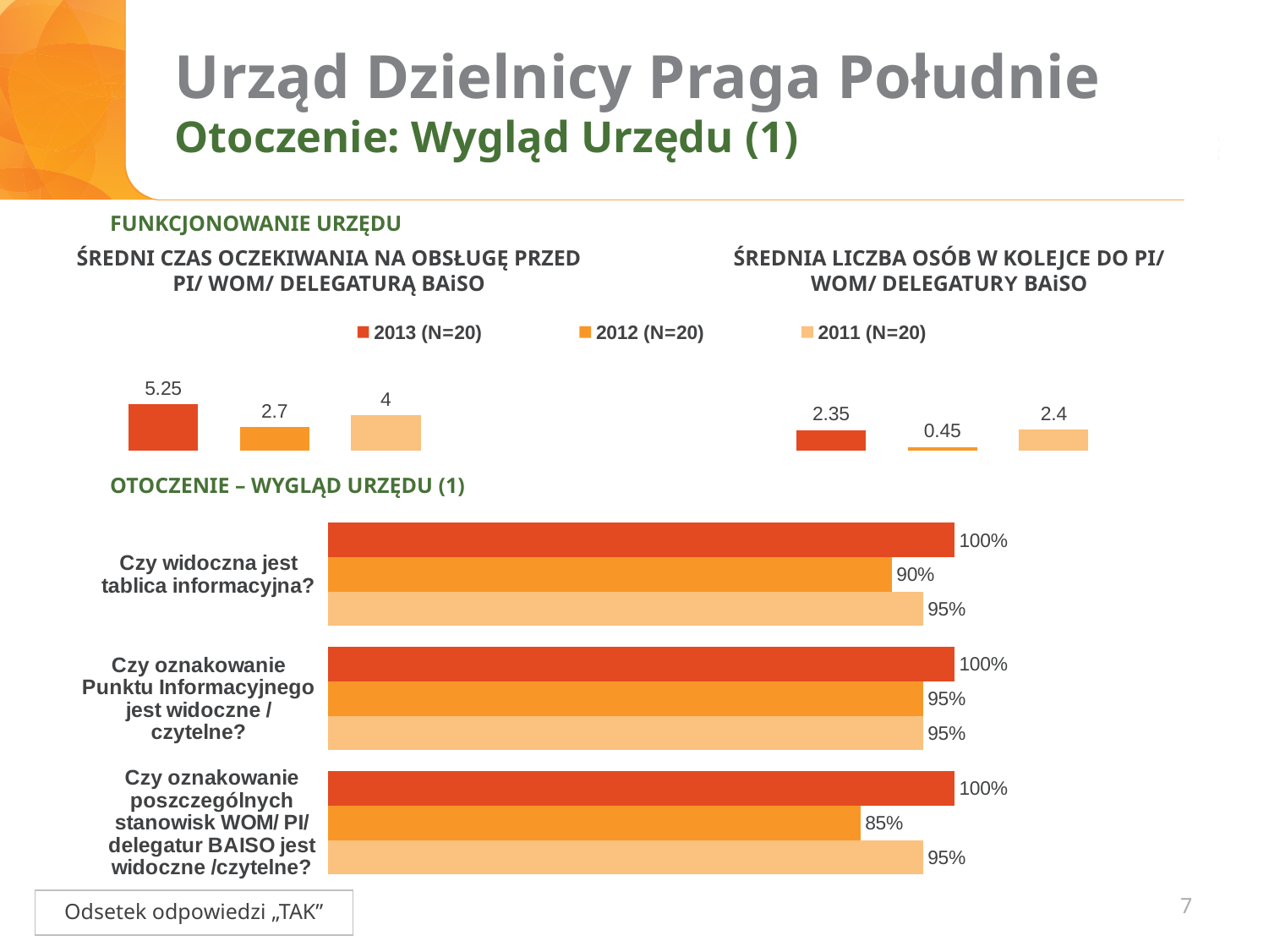
In the chart 'ŚREDNIA LICZBA OSÓB W KOLEJCE DO PI/ WOM/ DELEGATURY BAiSO', what is the value for 2012? 0.45 In the chart 'ŚREDNIA LICZBA OSÓB W KOLEJCE DO PI/ WOM/ DELEGATURY BAiSO', which year has the highest value? 2011 How many series does the legend shared by the top two charts list? 3 In the bottom chart 'OTOCZENIE – WYGLĄD URZĘDU (1)', what is the 2012 value for 'Czy oznakowanie poszczególnych stanowisk WOM/ PI/ delegatur BAISO jest widoczne /czytelne?'? 85% In the chart 'ŚREDNIA LICZBA OSÓB W KOLEJCE DO PI/ WOM/ DELEGATURY BAiSO', what is the difference between the 2013 and 2012 values? 1.9 What type of chart is the bottom chart 'OTOCZENIE – WYGLĄD URZĘDU (1)'? Bar chart In the bottom chart 'OTOCZENIE – WYGLĄD URZĘDU (1)', which is larger for 'Czy oznakowanie Punktu Informacyjnego jest widoczne / czytelne?': the 2013 value or the 2012 value? 2013 In the chart 'ŚREDNI CZAS OCZEKIWANIA NA OBSŁUGĘ PRZED PI/ WOM/ DELEGATURĄ BAiSO', what is the difference between the 2013 and 2011 values? 1.25 How many question categories are shown in the bottom chart 'OTOCZENIE – WYGLĄD URZĘDU (1)'? 3 In the chart 'ŚREDNI CZAS OCZEKIWANIA NA OBSŁUGĘ PRZED PI/ WOM/ DELEGATURĄ BAiSO', what is the value for 2013? 5.25 In the chart 'ŚREDNI CZAS OCZEKIWANIA NA OBSŁUGĘ PRZED PI/ WOM/ DELEGATURĄ BAiSO', which year has the lowest value? 2012 In the bottom chart 'OTOCZENIE – WYGLĄD URZĘDU (1)', what is the 2012 value for 'Czy widoczna jest tablica informacyjna?'? 90%